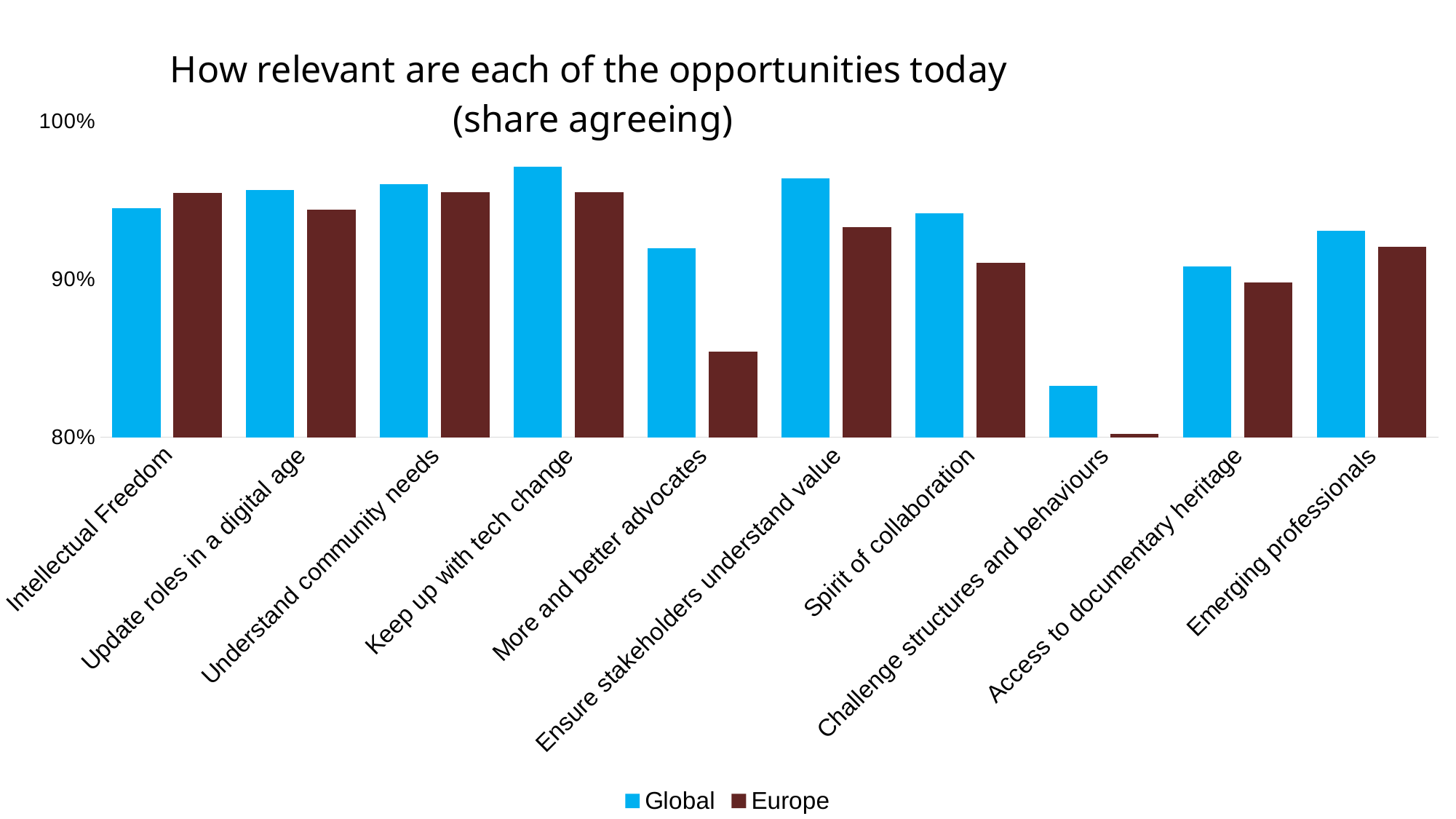
Is the Europe value for More and better advocates greater or less than 90%? less Is the Global value for Challenge structures and behaviours greater or less than 90%? less What is the title of the chart? How relevant are each of the opportunities today (share agreeing) Which category has the lowest Europe value? Challenge structures and behaviours Which category has the highest Global value? Keep up with tech change How many series does the legend list? 2 Is the Global value for More and better advocates greater or less than 90%? greater For Ensure stakeholders understand value, which series has the larger value, Global or Europe? Global What kind of chart is shown on the slide? bar chart How many categories are shown on the x axis? 10 Which category has the lowest Global value? Challenge structures and behaviours